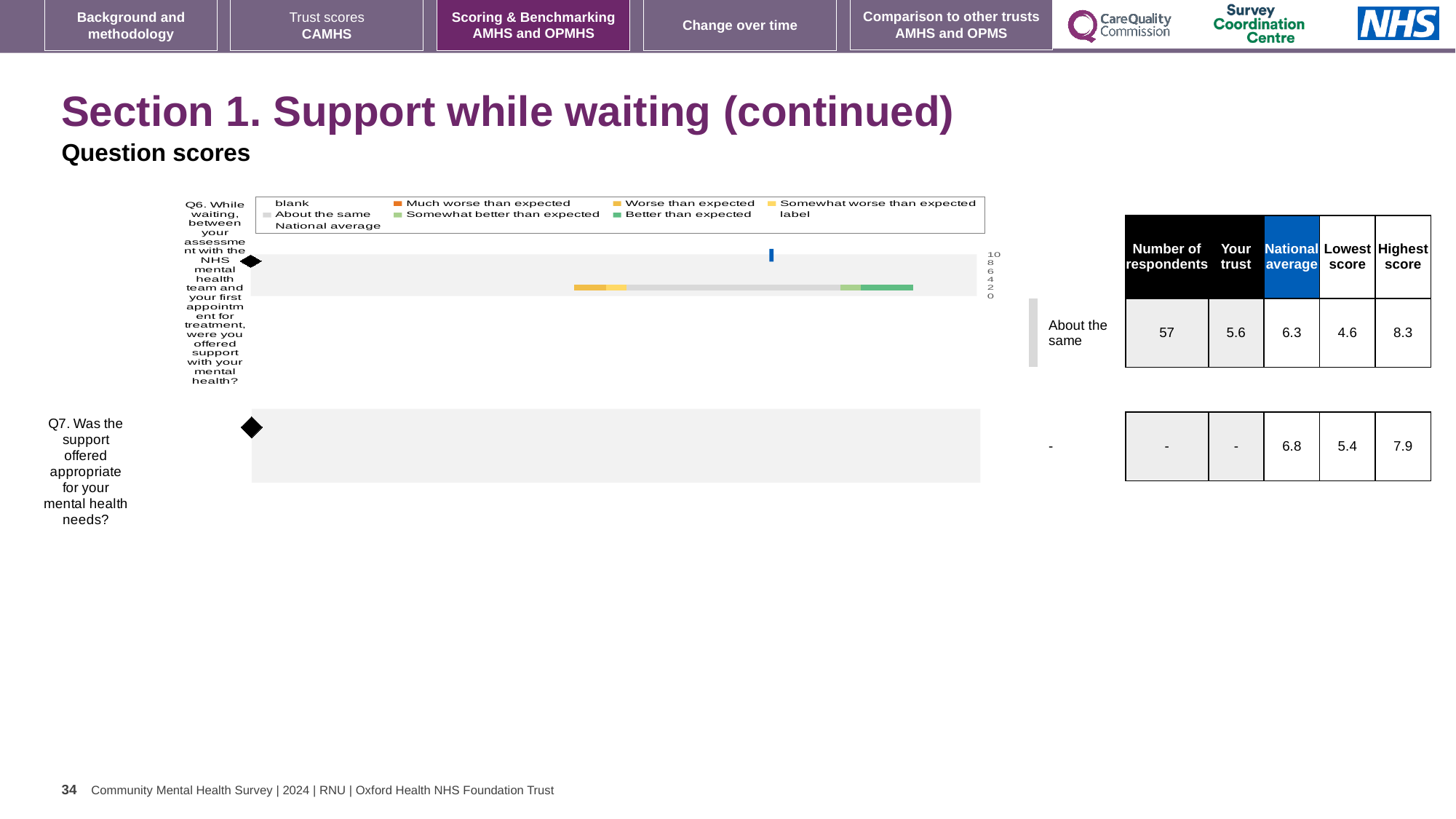
For Q6, what is the difference between the Highest score and the Lowest score shown in the table? 3.7 For Q6, what is the National average score shown in the table next to the chart? 6.3 In the Q6 chart legend, which entry is shown in dark green? Better than expected For Q6, which benchmark category is the trust's score placed in, as labelled beside the chart? About the same What is the lowest tick value shown on the axis of the Q6 chart? 0 What kind of chart is used for Q6 on this slide? bar chart How many entries does the legend of the Q6 chart list? 9 For Q6, what is the 'Your trust' score shown in the table next to the chart? 5.6 For Q6, which is larger: the Your trust score or the National average score? National average What is the highest tick value shown on the axis of the Q6 chart? 10 For Q6, what is the number of respondents shown in the table next to the chart? 57 In the Q6 chart legend, which entry is shown in orange? Much worse than expected